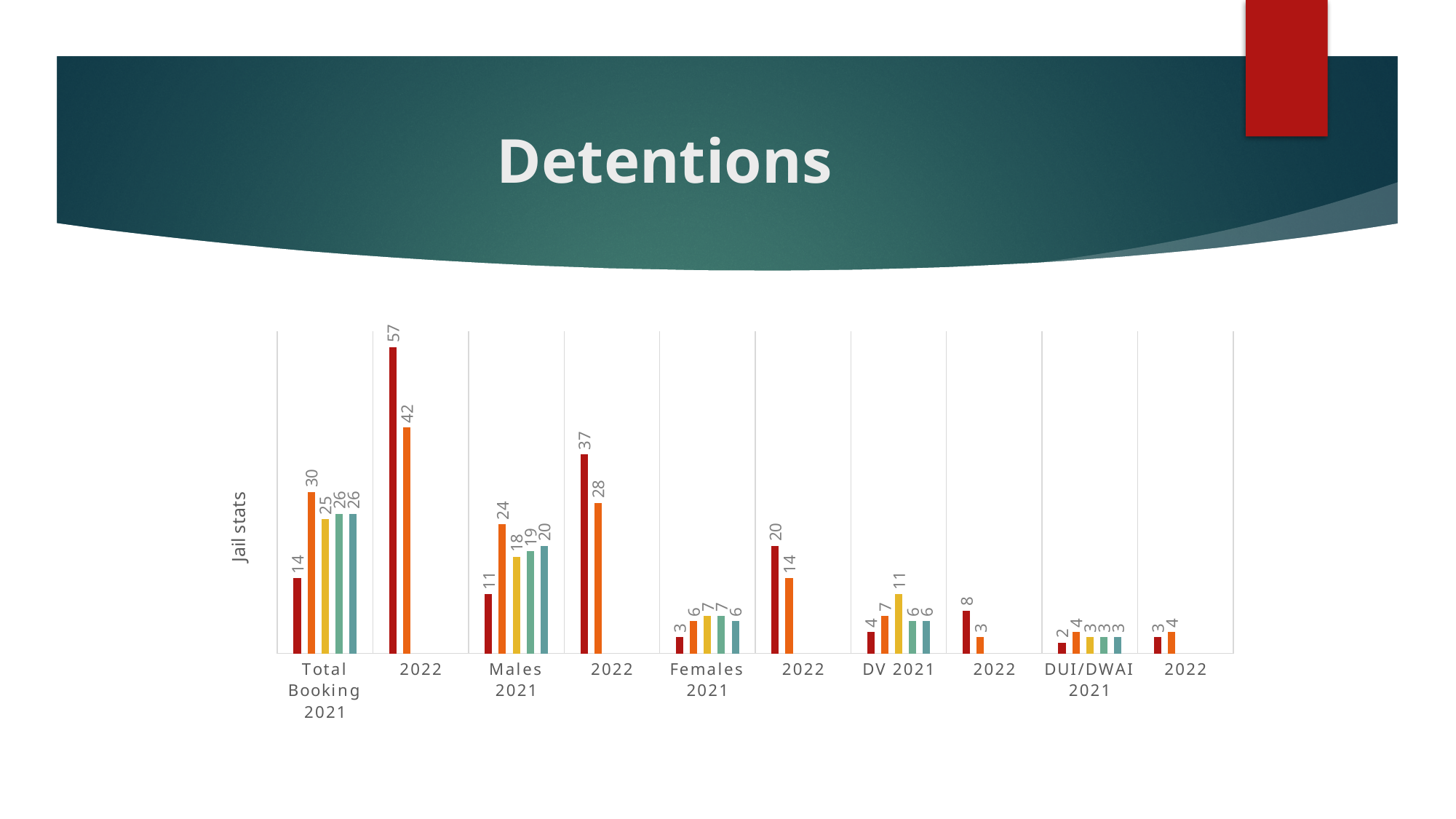
What is the value of the orange bar in the Total Booking 2021 group? 30 What is the value of the first (dark red) bar in the Total Booking 2021 group? 14 What is the value of the tallest bar in the 2022 group next to Total Booking 2021? 57 What is the highest value labelled anywhere on the chart? 57 What is the label on the vertical axis of the chart? Jail stats Which bar in the Males 2021 group has the highest value? the orange bar (24) Which is larger: the dark red bar in the Females 2021 group or the dark red bar in the 2022 group next to it? the 2022 bar (20) What is the value of the yellow bar in the DV 2021 group? 11 What is the difference between the two bars in the 2022 group next to Total Booking 2021 (57 and 42)? 15 How many category groups are shown along the x axis? 10 What is the difference between the dark red bar (37) and the orange bar (28) in the 2022 group next to Males 2021? 9 What type of chart is shown on the slide? bar chart